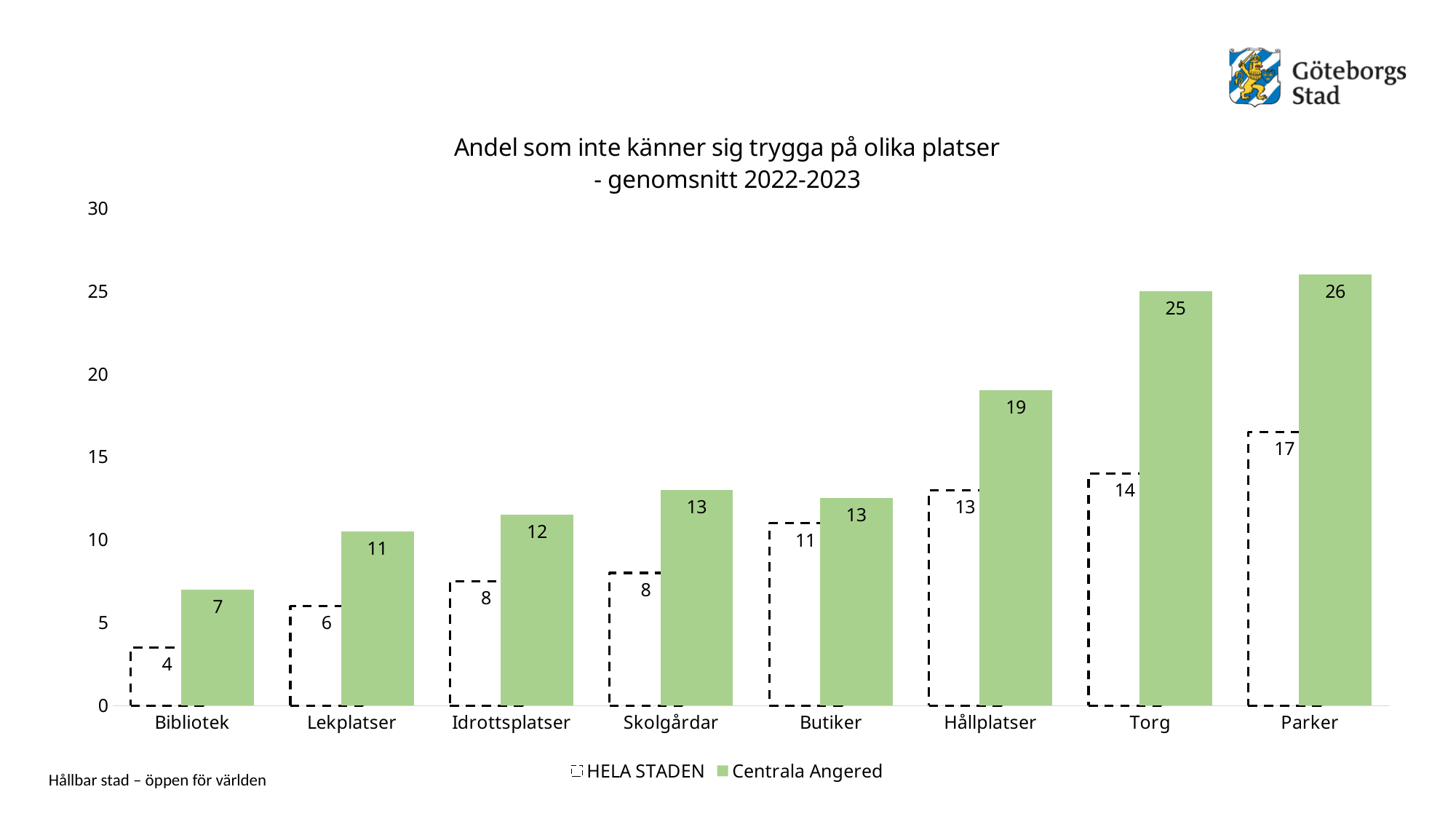
What is the value for HELA STADEN at Bibliotek? 4 What is the value for Centrala Angered at Hållplatser? 19 Is the value for Centrala Angered at Torg greater or less than 20? greater How many series does the legend list? 2 How many categories are shown on the x axis? 8 What is the difference between Centrala Angered and HELA STADEN at Torg? 11 What kind of chart is shown on the slide? bar chart Do the Centrala Angered values rise or fall from Bibliotek to Parker? rise Which category has the highest value for Centrala Angered? Parker Which category has the lowest value for HELA STADEN? Bibliotek Which is larger at Lekplatser: HELA STADEN or Centrala Angered? Centrala Angered What is the value for Centrala Angered at Parker? 26